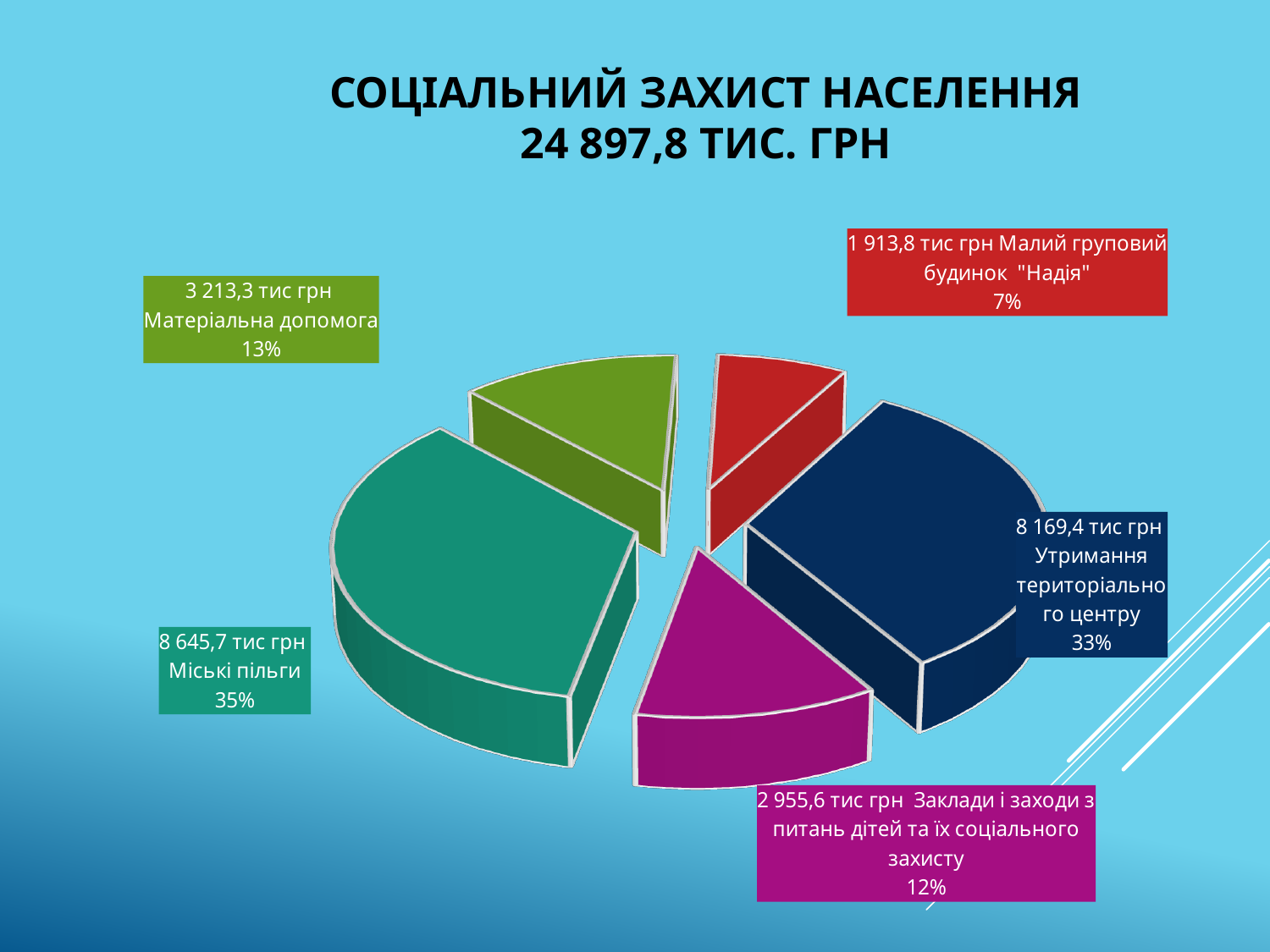
How many slices does the pie chart have? 5 What total amount is stated in the chart title? 24 897,8 тис. грн What kind of chart is shown on the slide? pie chart Which category has the largest slice? Міські пільги What share of the pie does Матеріальна допомога represent? 13% What is the value for Утримання територіального центру? 8 169,4 тис грн Which is larger: the value for Матеріальна допомога or the value for Заклади і заходи з питань дітей та їх соціального захисту? Матеріальна допомога What is the value for Малий груповий будинок "Надія"? 1 913,8 тис грн What is the difference between the values for Міські пільги and Утримання територіального центру? 476,3 тис грн Which category has the smallest slice? Малий груповий будинок "Надія" What is the value for Міські пільги? 8 645,7 тис грн What share of the pie does Заклади і заходи з питань дітей та їх соціального захисту represent? 12%